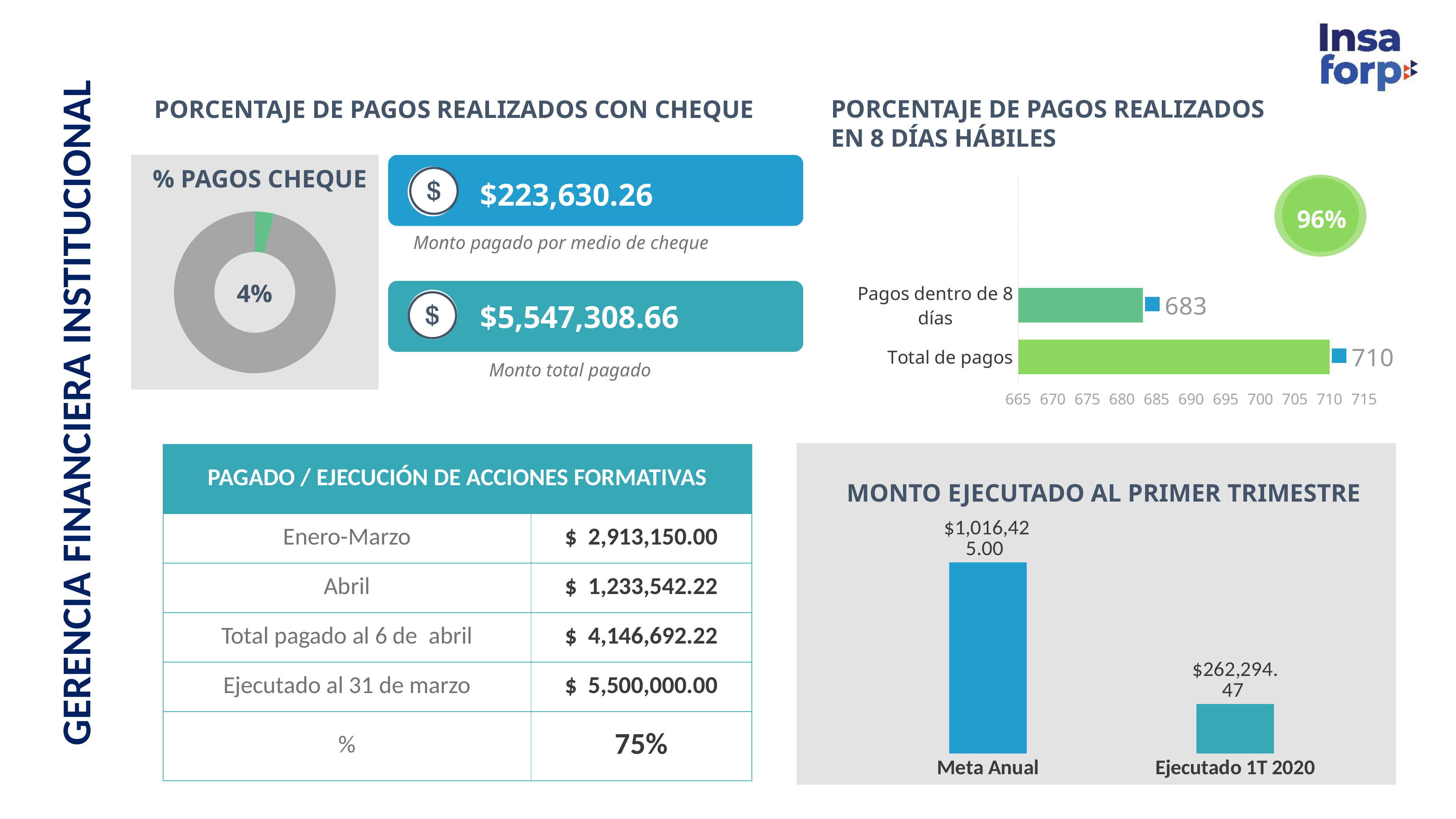
In the 'PORCENTAJE DE PAGOS REALIZADOS EN 8 DÍAS HÁBILES' chart, what is the value for 'Pagos dentro de 8 días'? 683 In the 'MONTO EJECUTADO AL PRIMER TRIMESTRE' chart, what is the value for 'Meta Anual'? $1,016,425.00 In the 'PORCENTAJE DE PAGOS REALIZADOS EN 8 DÍAS HÁBILES' chart, what is the difference between 'Total de pagos' and 'Pagos dentro de 8 días'? 27 In the 'PORCENTAJE DE PAGOS REALIZADOS EN 8 DÍAS HÁBILES' chart, what kind of chart is shown? Bar chart In the 'PORCENTAJE DE PAGOS REALIZADOS EN 8 DÍAS HÁBILES' chart, what percentage is shown in the green circle? 96% In the 'PORCENTAJE DE PAGOS REALIZADOS EN 8 DÍAS HÁBILES' chart, how many categories are plotted? 2 In the 'MONTO EJECUTADO AL PRIMER TRIMESTRE' chart, what is the value for 'Ejecutado 1T 2020'? $262,294.47 In the 'PORCENTAJE DE PAGOS REALIZADOS EN 8 DÍAS HÁBILES' chart, which category has the higher value? Total de pagos In the '% PAGOS CHEQUE' chart, what kind of chart is shown? Donut chart In the 'MONTO EJECUTADO AL PRIMER TRIMESTRE' chart, which category has the lower value? Ejecutado 1T 2020 In the '% PAGOS CHEQUE' chart, what percentage is shown in the centre of the donut? 4% In the 'PORCENTAJE DE PAGOS REALIZADOS EN 8 DÍAS HÁBILES' chart, what is the value for 'Total de pagos'? 710